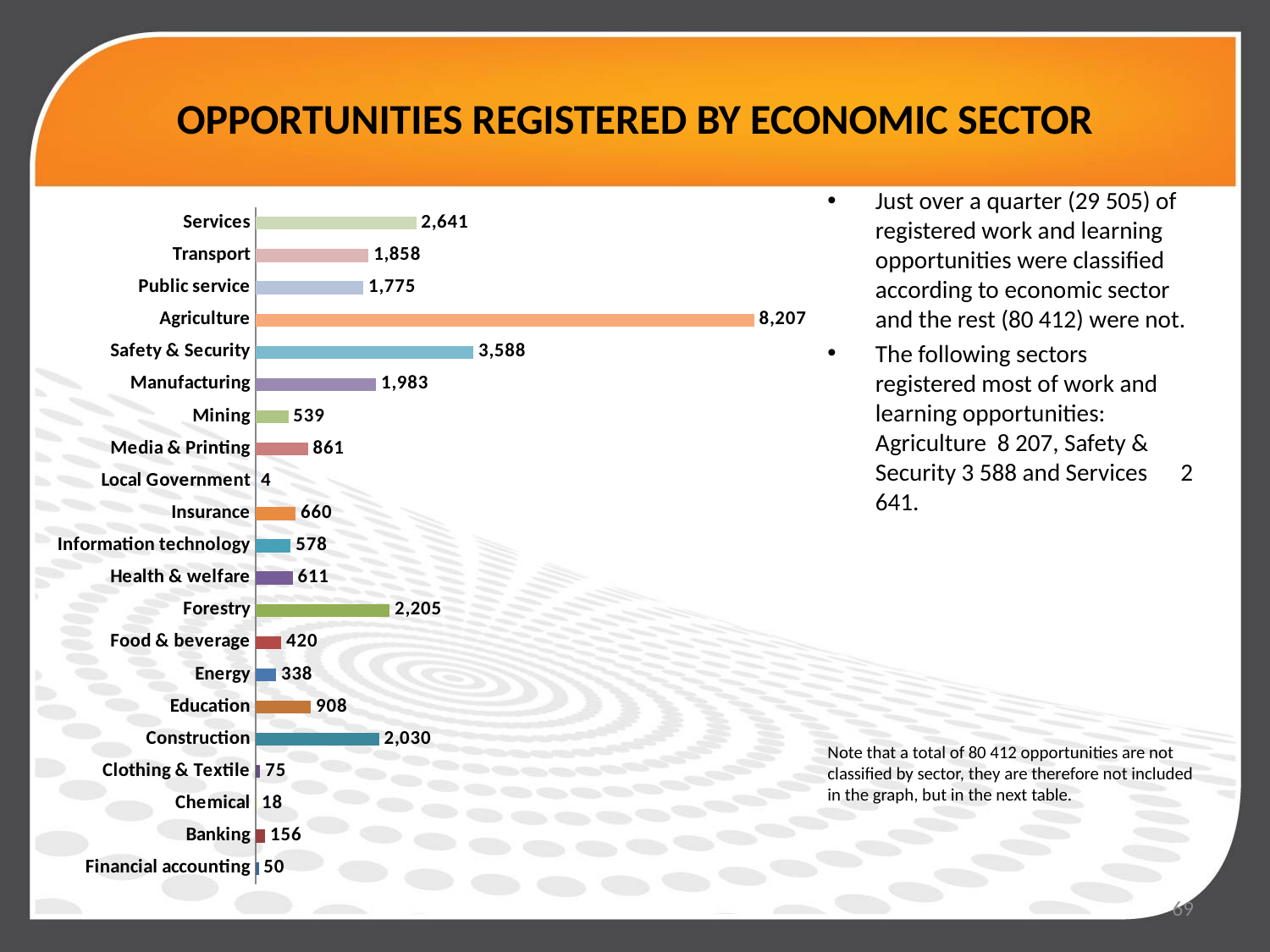
How many sectors are shown in the chart? 21 What value is shown for Chemical? 18 Which is larger, the value for Construction or the value for Manufacturing? Construction Which sector has the highest number of registered opportunities? Agriculture What is the title of the slide containing the chart? OPPORTUNITIES REGISTERED BY ECONOMIC SECTOR What kind of chart is shown on the slide? Bar chart What value is shown for Forestry? 2,205 What is the difference between the values for Agriculture and Safety & Security? 4,619 What is the difference between the values for Services and Forestry? 436 What value is shown for Safety & Security? 3,588 Which sector has the lowest number of registered opportunities? Local Government What value is shown for Agriculture? 8,207